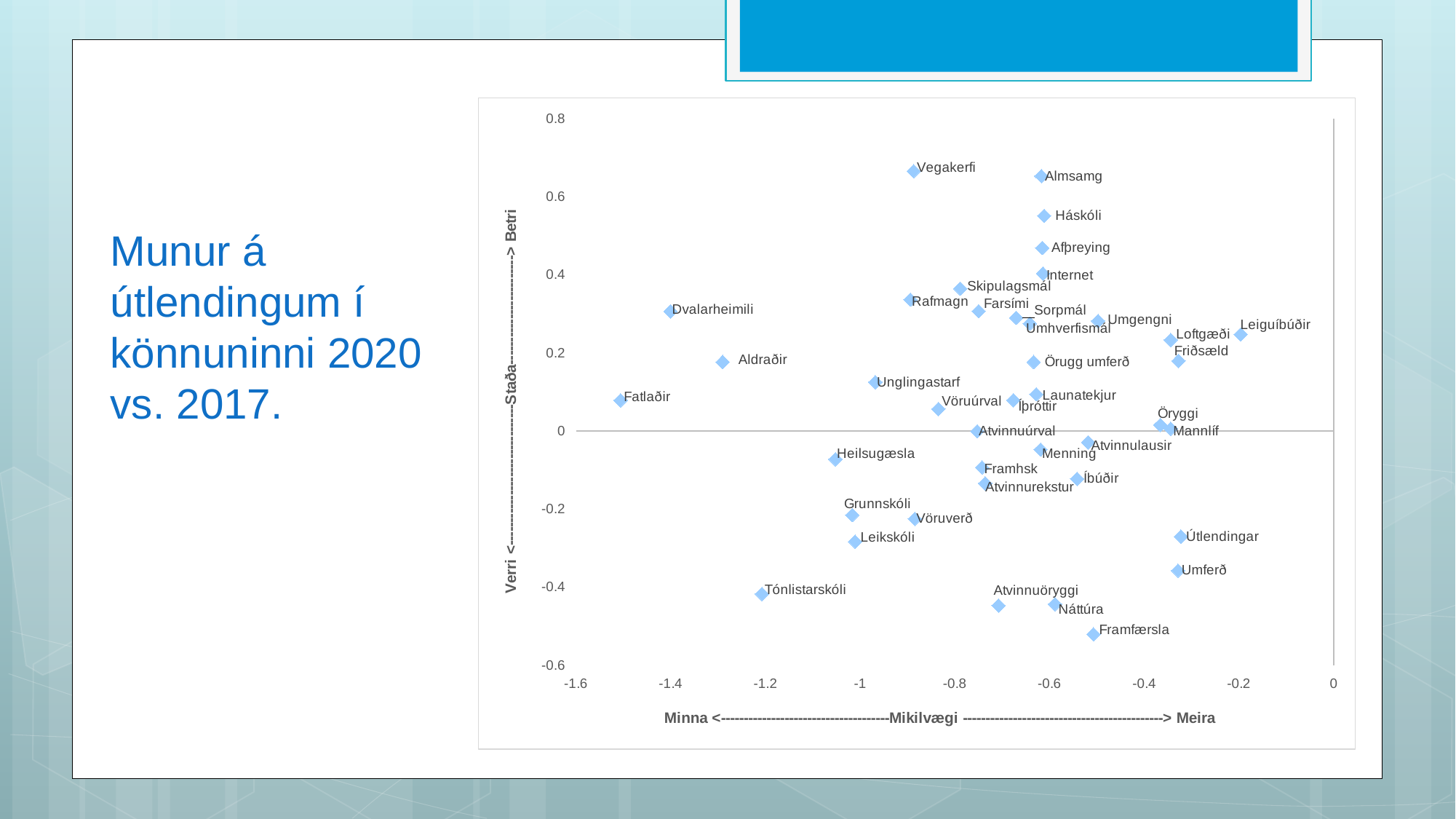
Is the vertical-axis value for Vegakerfi greater or less than 0.6? greater Is the horizontal-axis value for Fatlaðir greater or less than -1.4? less Which point is further right on the horizontal axis, Fatlaðir or Leiguíbúðir? Leiguíbúðir What is the title text shown to the left of the chart? Munur á útlendingum í könnuninni 2020 vs. 2017. Which point is higher on the vertical axis, Vegakerfi or Aldraðir? Vegakerfi What kind of chart is shown on the slide? scatter chart Is the vertical-axis value for Framfærsla greater or less than -0.4? less Which point is lowest on the vertical (Staða) axis? Framfærsla Which point is furthest left on the horizontal (Mikilvægi) axis? Fatlaðir Which point is furthest right on the horizontal (Mikilvægi) axis? Leiguíbúðir